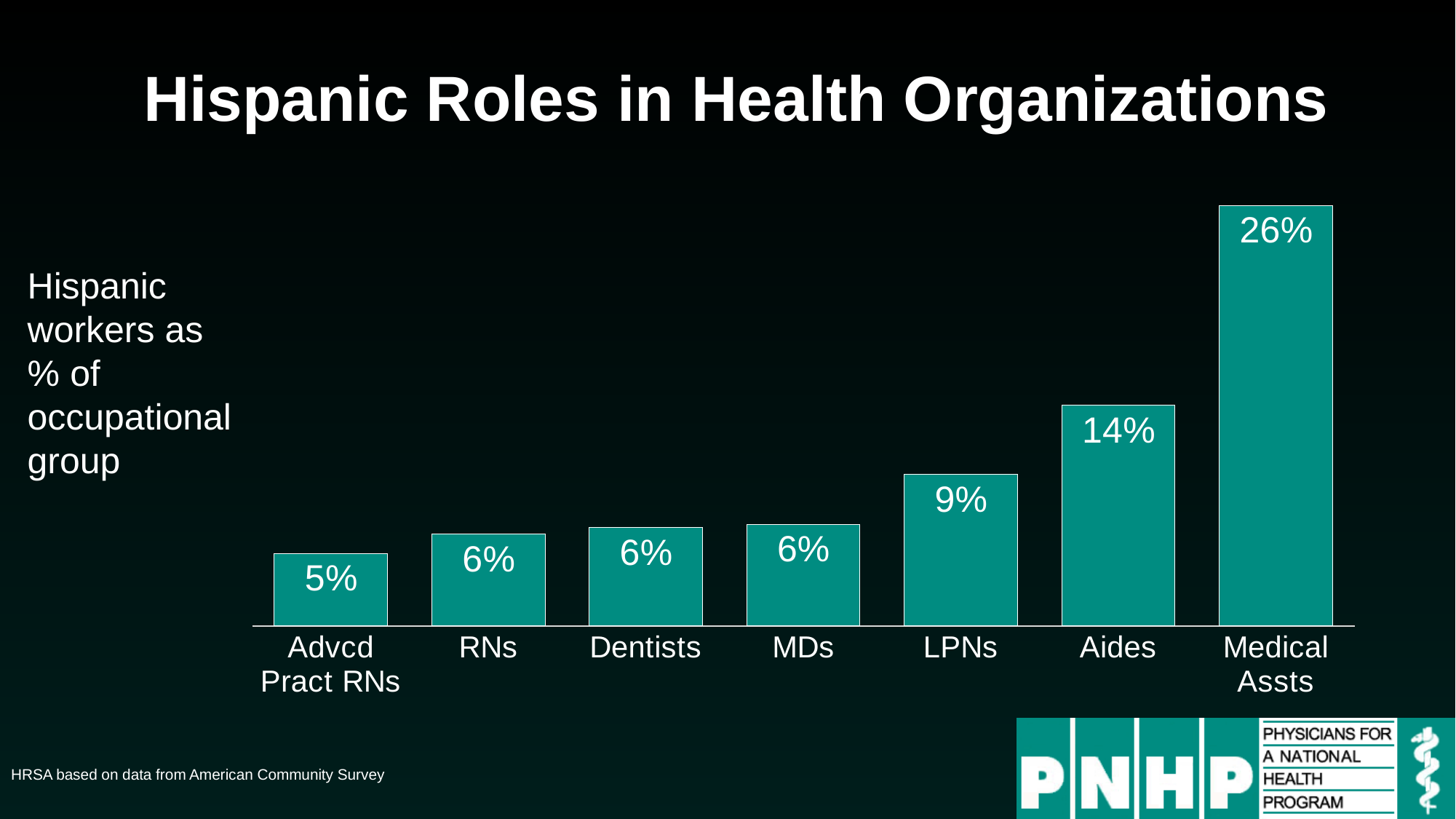
What is the difference between the values for Medical Assts and Aides? 12% Do the values rise or fall moving from left to right across the categories? Rise Which is larger, the value for Aides or the value for LPNs? Aides What percentage of Medical Assts are Hispanic workers? 26% Which occupational group has the highest share of Hispanic workers? Medical Assts What is the difference between the values for LPNs and MDs? 3% What is the value shown for Advcd Pract RNs? 5% What is the value shown for Aides? 14% How many occupational groups are shown in the chart? 7 What kind of chart is shown on the slide? Bar chart Which occupational group has the lowest share of Hispanic workers? Advcd Pract RNs What is the value shown for LPNs? 9%